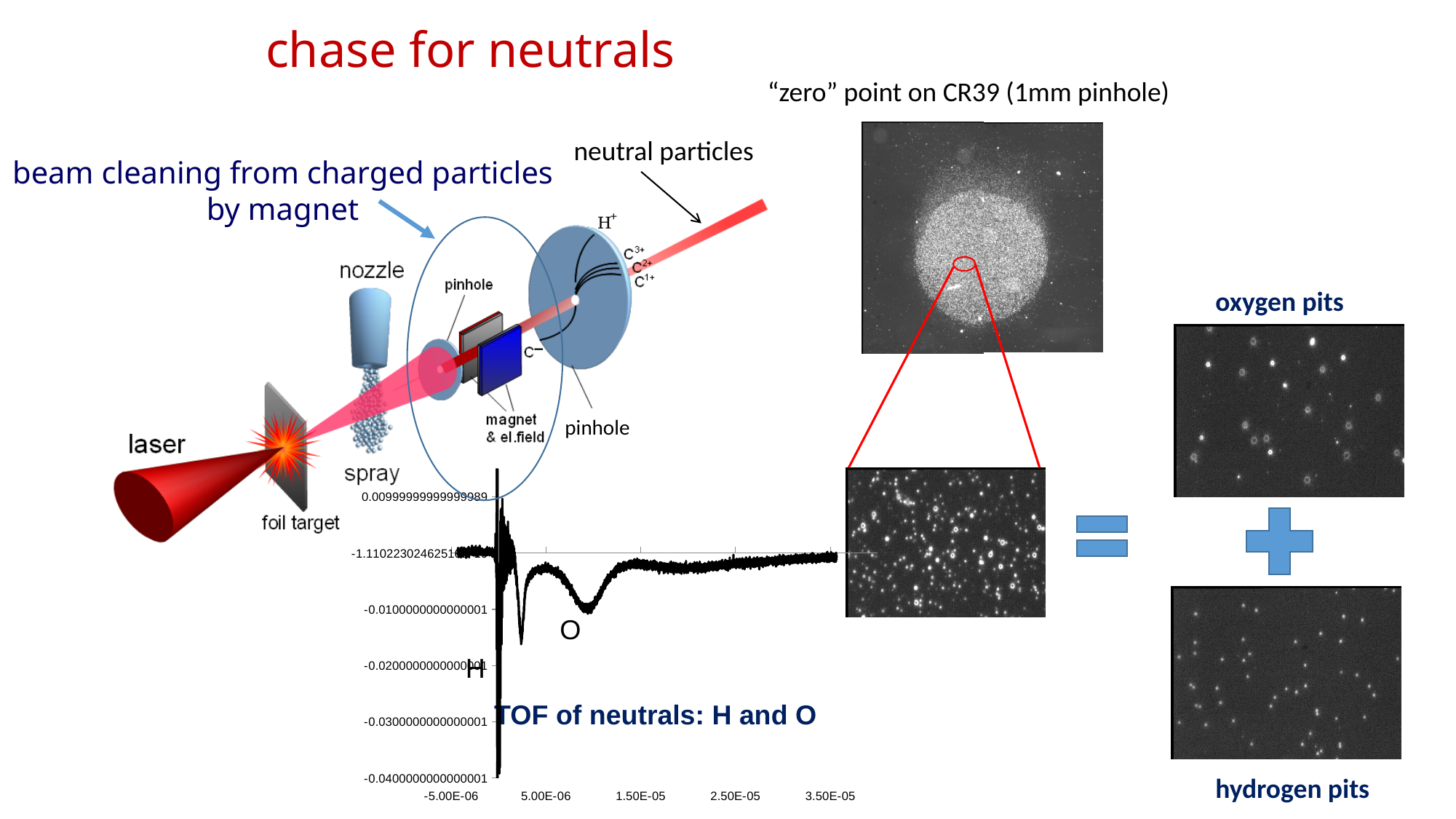
In the 'TOF of neutrals' chart, is the minimum value of the O dip greater or less than -0.02? greater In the 'TOF of neutrals' chart, after the O dip, does the signal rise or fall as x increases toward 3.50E-05? rise In the 'TOF of neutrals' chart, which dip reaches a lower value, H or O? H What kind of chart is the 'TOF of neutrals: H and O' chart? line chart What is the title of the chart at the bottom of the slide? TOF of neutrals: H and O In the 'TOF of neutrals' chart, which two species are labelled on the signal dips? H and O How many tick labels are shown on the x axis of the 'TOF of neutrals' chart? 5 In the 'TOF of neutrals' chart, which dip appears first along the x axis, H or O? H In the 'TOF of neutrals' chart, is the minimum value of the H dip greater or less than -0.03? less